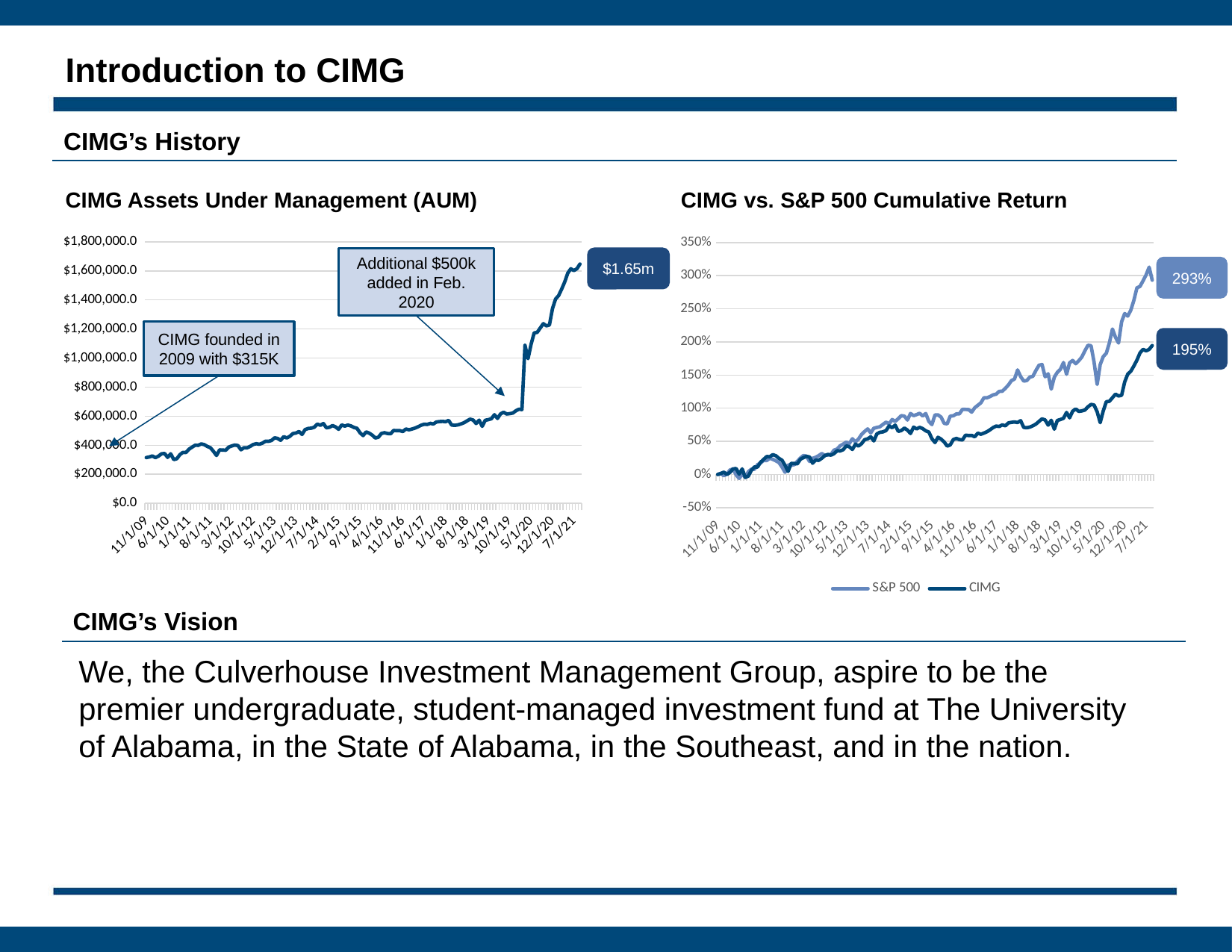
According to the callout on the 'CIMG Assets Under Management (AUM)' chart, with how much was CIMG founded in 2009? $315K In the 'CIMG vs. S&P 500 Cumulative Return' chart, which series ends with the higher cumulative return, S&P 500 or CIMG? S&P 500 In the 'CIMG Assets Under Management (AUM)' chart, what is the final AUM value labelled at the end of the line? $1.65m In the 'CIMG vs. S&P 500 Cumulative Return' chart, what is the final cumulative return labelled for CIMG? 195% What kind of chart is the 'CIMG Assets Under Management (AUM)' chart? line chart What kind of chart is the 'CIMG vs. S&P 500 Cumulative Return' chart? line chart In the 'CIMG vs. S&P 500 Cumulative Return' chart, which two series are listed in the legend? S&P 500 and CIMG In the 'CIMG vs. S&P 500 Cumulative Return' chart, how many series does the legend list? 2 In the 'CIMG vs. S&P 500 Cumulative Return' chart, what is the final cumulative return labelled for the S&P 500? 293% In the 'CIMG Assets Under Management (AUM)' chart, do the values generally rise or fall from 11/1/09 to 7/1/21? rise In the 'CIMG vs. S&P 500 Cumulative Return' chart, by how many percentage points does the S&P 500's final labelled return exceed CIMG's? 98 percentage points In the 'CIMG Assets Under Management (AUM)' chart, is the AUM at 11/1/09 greater or less than $400,000.0? less